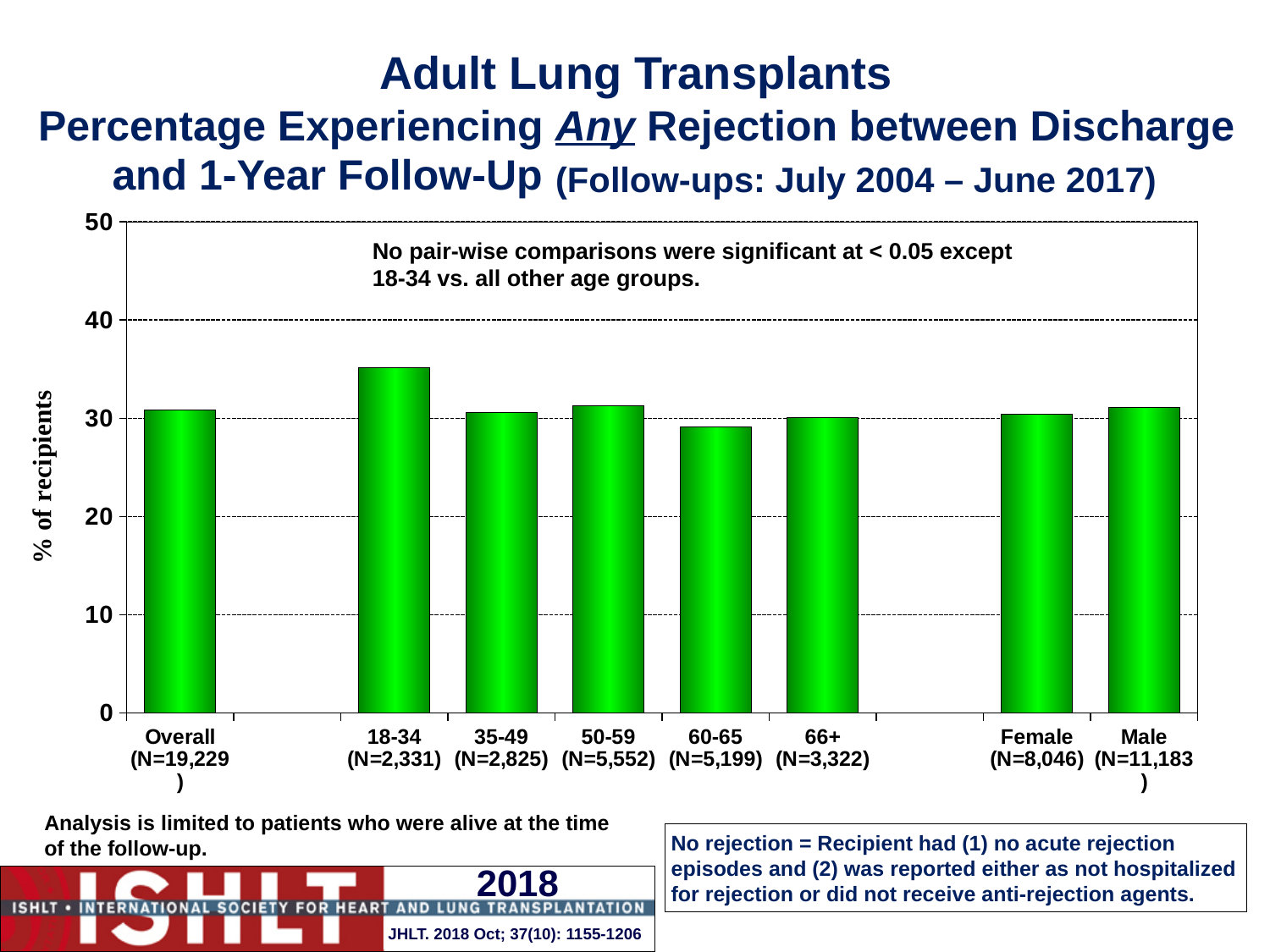
What is the label of the vertical axis? % of recipients What is the sample size (N) shown for the Overall category? N=19,229 How many bars (categories) are plotted in the chart? 8 Is the value for the 60-65 age group greater or less than 40? less Which category has the highest percentage of recipients experiencing any rejection? 18-34 Which is larger, the value for the 18-34 age group or the value for the 60-65 age group? 18-34 Is the value for the 18-34 age group greater or less than 30? greater Is the value for Female greater or less than 40? less What kind of chart is shown on the slide? bar chart Which is larger, the value for the 18-34 age group or the value for Male? 18-34